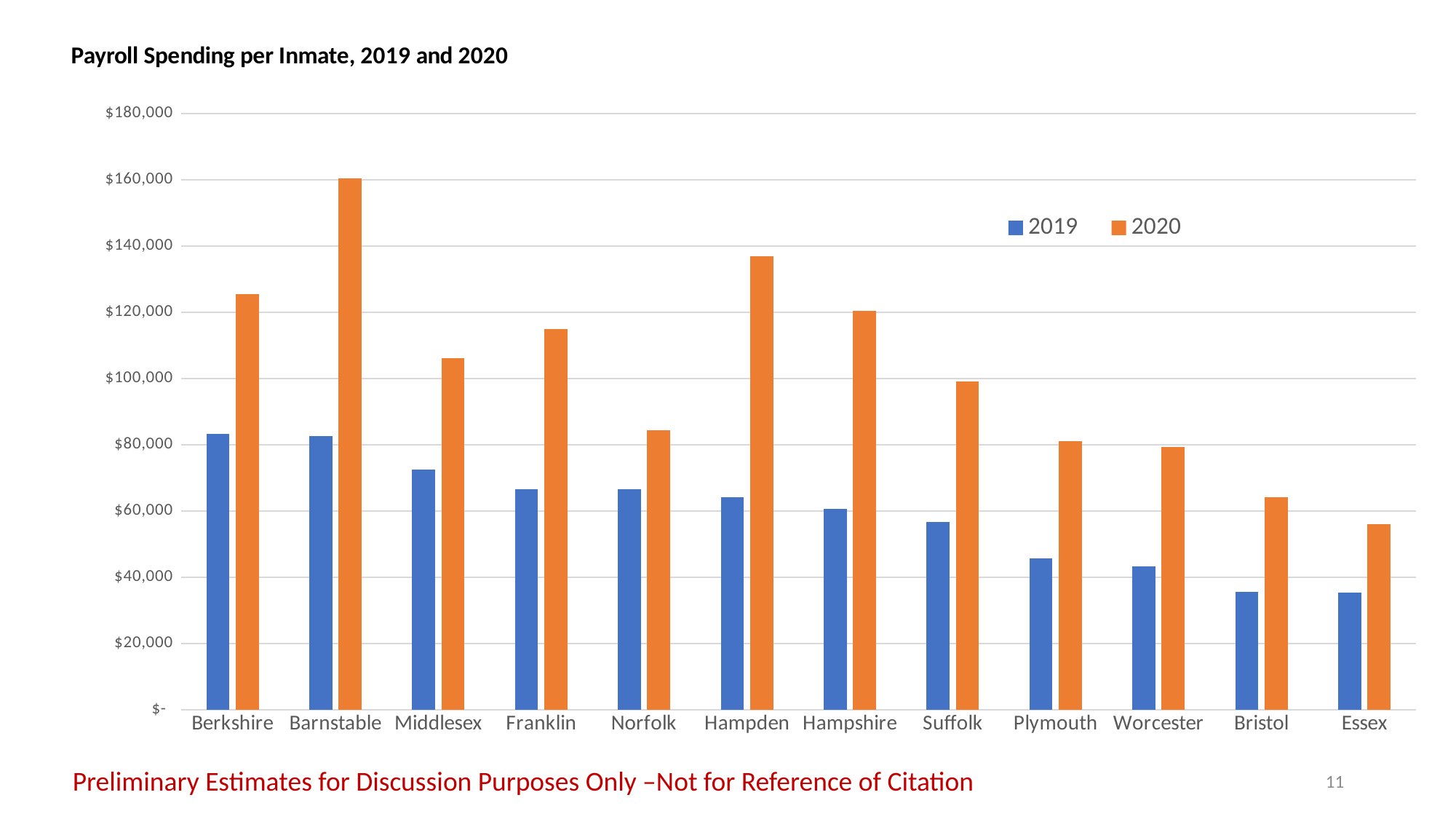
What kind of chart is shown on the slide? Bar chart Do the 2019 values generally rise or fall moving from Berkshire to Essex along the x axis? fall Which county has the lowest 2020 payroll spending per inmate? Essex What is the title of the chart? Payroll Spending per Inmate, 2019 and 2020 Which is larger, the 2020 value for Hampden or the 2020 value for Hampshire? Hampden Is the 2019 value for Middlesex greater or less than $80,000? less How many series does the legend list? 2 How many counties are shown on the x axis of the chart? 12 Is the 2020 value for Essex greater or less than $60,000? less Is the 2020 value for Barnstable greater or less than $140,000? greater Which county has the highest 2020 payroll spending per inmate? Barnstable